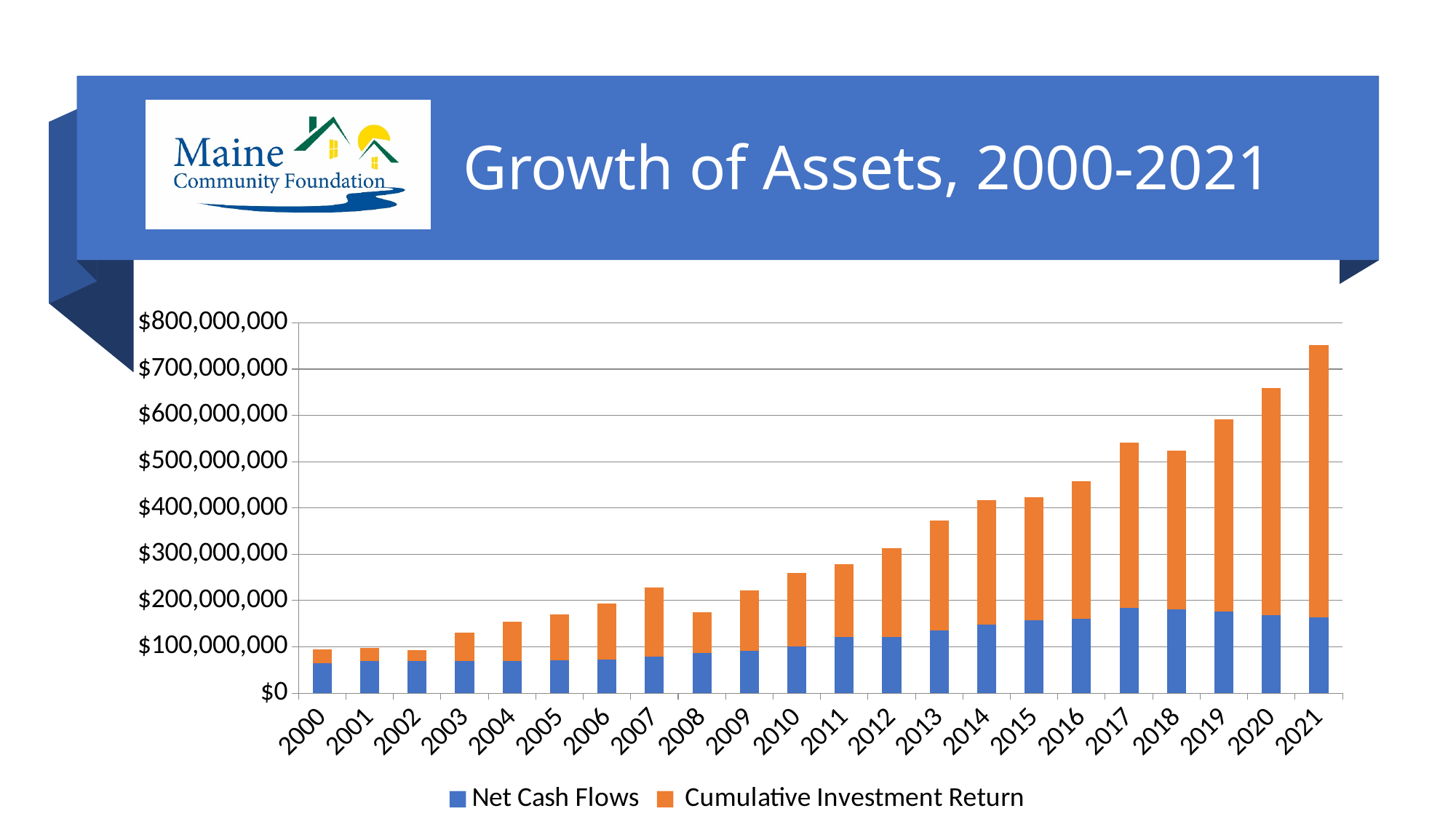
What kind of chart is shown on the slide? Stacked bar chart What is the title of the slide's chart? Growth of Assets, 2000-2021 Which year has the larger total, 2007 or 2008? 2007 Is the Net Cash Flows value for 2017 greater or less than $100,000,000? greater Which year has the highest total assets? 2021 Do total assets generally rise or fall from 2000 to 2021? Rise Is the total value for 2021 greater or less than $700,000,000? greater Is the total value for 2010 greater or less than $300,000,000? less Which year has the larger total, 2018 or 2019? 2019 How many series does the legend list? 2 How many years are shown along the x axis? 22